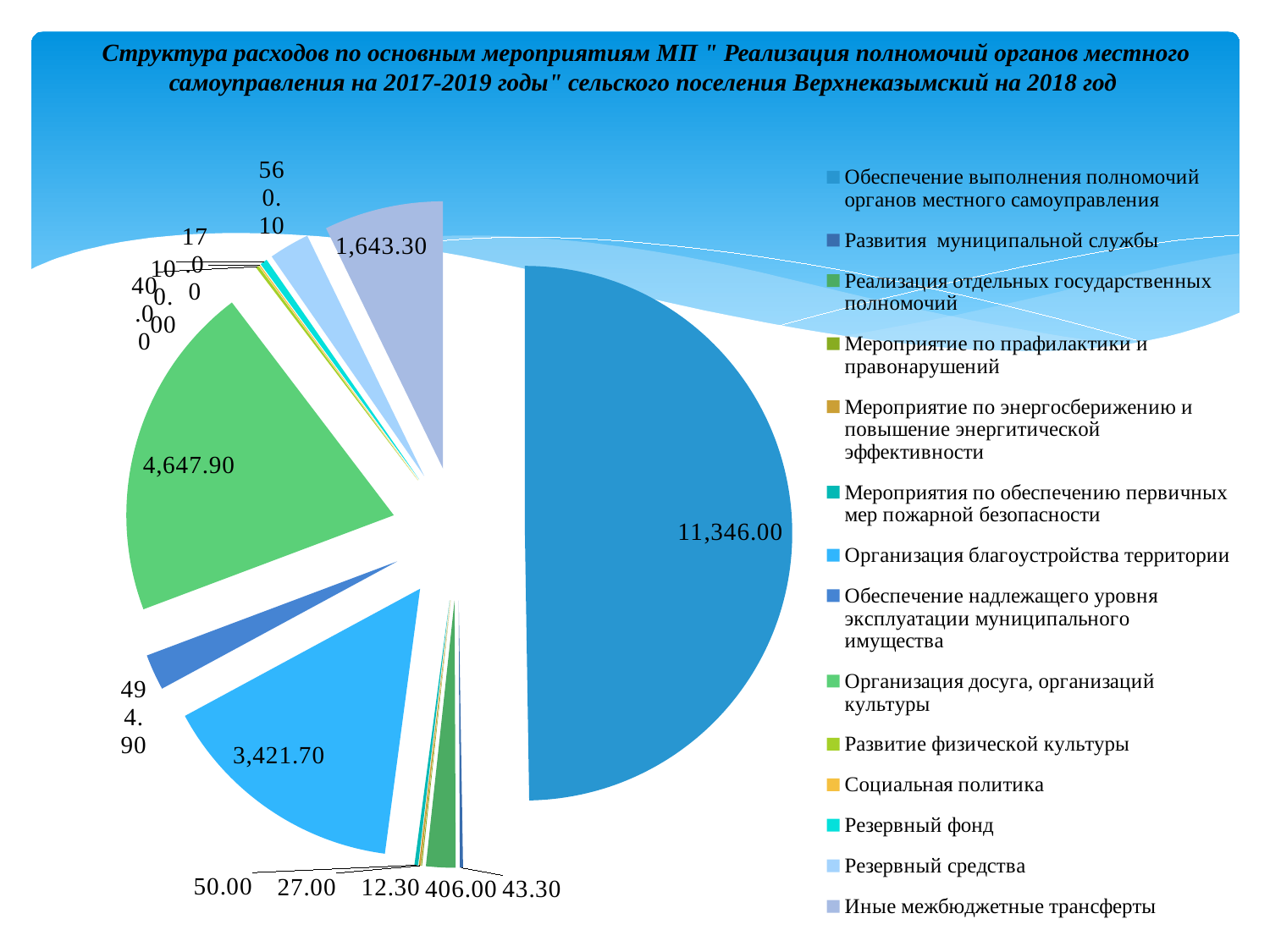
What is the smallest data label value shown on the pie chart? 12.30 For which year does the chart title say the expenditure structure is shown? 2018 What is the difference between the largest slice (11,346.00) and the slice for Организация досуга, организаций культуры? 6,698.10 Which is larger: Организация досуга, организаций культуры or Организация благоустройства территории? Организация досуга, организаций культуры What is the value shown for the largest slice of the pie? 11,346.00 What is the value for Организация благоустройства территории? 3,421.70 What is the value for Организация досуга, организаций культуры? 4,647.90 What kind of chart is shown on the slide? pie chart What is the difference between the values for Организация досуга, организаций культуры and Организация благоустройства территории? 1,226.20 Which category has the largest slice of the pie? Обеспечение выполнения полномочий органов местного самоуправления What is the value for Иные межбюджетные трансферты? 1,643.30 How many entries does the legend list? 14